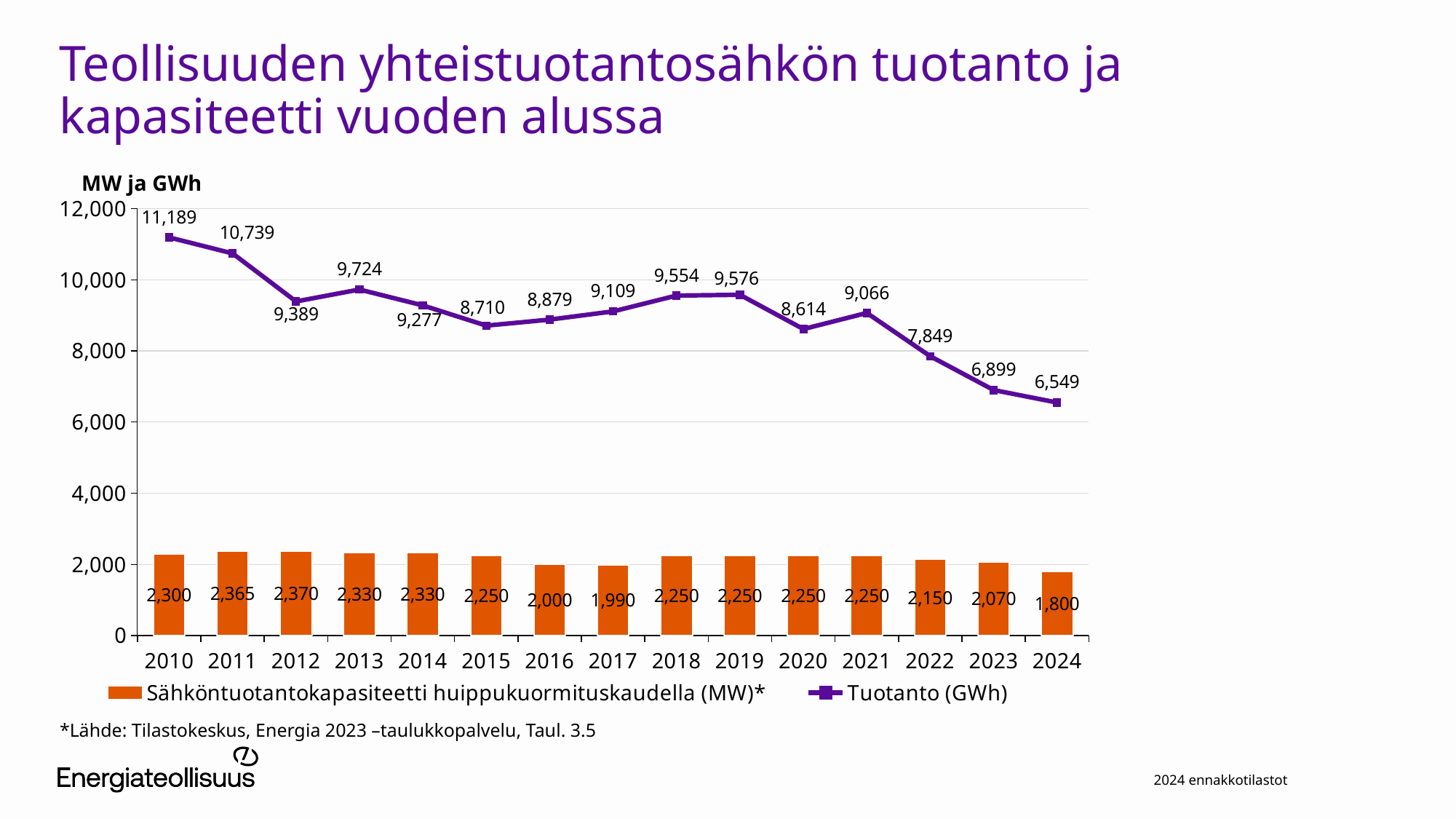
What is the difference between the Tuotanto (GWh) values for 2010 and 2024? 4,640 What is the Tuotanto (GWh) value for 2010? 11,189 How many years are shown on the x axis? 15 What kind of chart is shown on the slide? Combined bar and line chart Does the Tuotanto (GWh) series rise or fall from 2019 to 2024? fall What is the Tuotanto (GWh) value for 2019? 9,576 Which year has the lowest Sähköntuotantokapasiteetti huippukuormituskaudella (MW) value? 2024 What is the Sähköntuotantokapasiteetti huippukuormituskaudella (MW) value for 2024? 1,800 How many series does the legend list? 2 Which year has the larger Tuotanto (GWh) value, 2015 or 2021? 2021 Which year has the highest Tuotanto (GWh) value? 2010 Is the Tuotanto (GWh) value for 2022 greater or less than 8,000? less